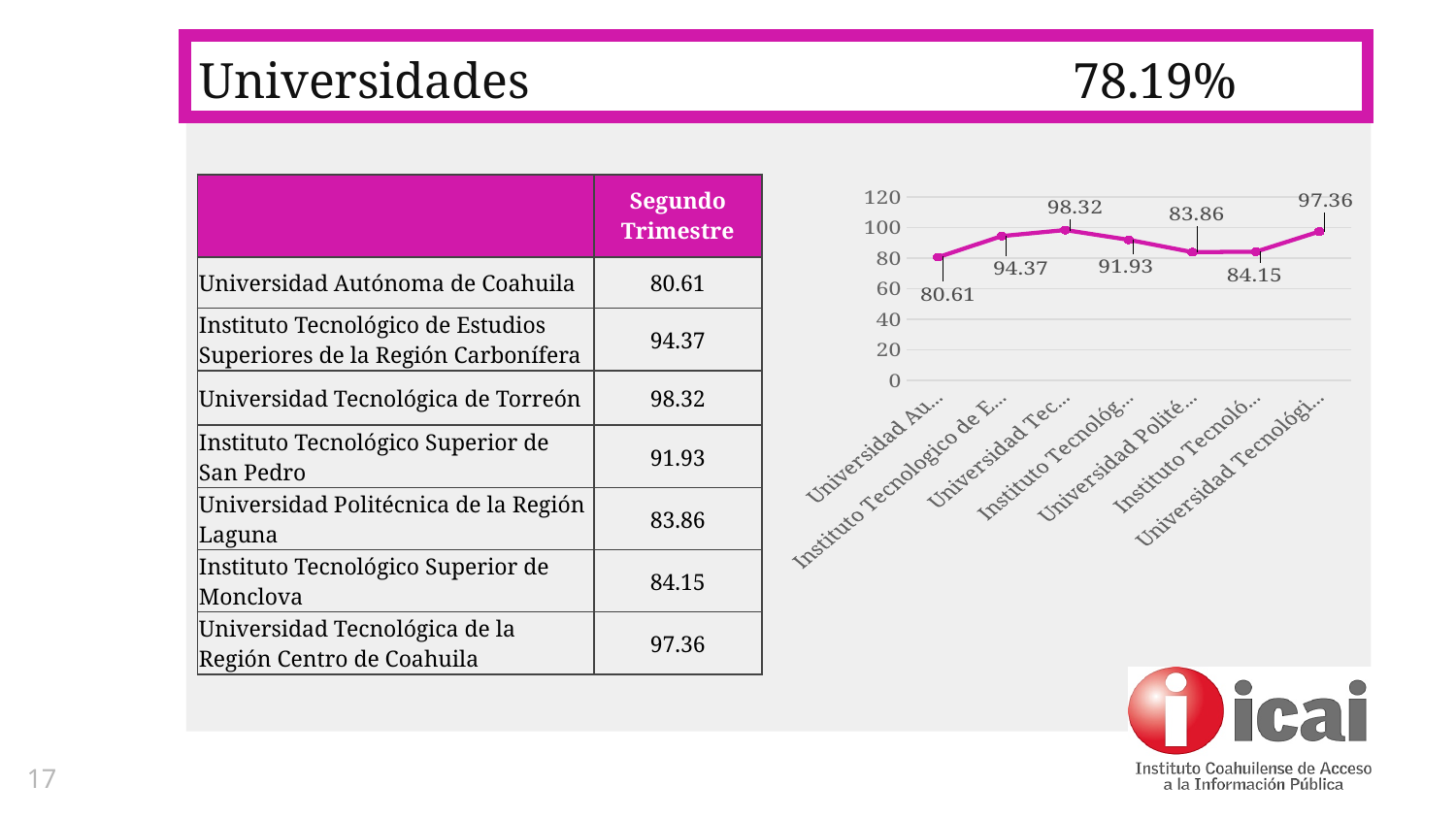
Which is larger on the line chart: the value for Instituto Tecnológico de Estudios Superiores de la Región Carbonífera or the value for Instituto Tecnológico Superior de San Pedro? Instituto Tecnológico de Estudios Superiores de la Región Carbonífera What is the value plotted for Universidad Tecnológica de Torreón, the third point on the line chart? 98.32 What is the value plotted for Universidad Autónoma de Coahuila, the first point on the line chart? 80.61 What is the difference between the values for Universidad Tecnológica de la Región Centro de Coahuila (97.36) and Instituto Tecnológico Superior de Monclova (84.15) on the line chart? 13.21 What is the value plotted for Instituto Tecnológico Superior de Monclova, the sixth point on the line chart? 84.15 What is the maximum value shown on the vertical axis of the line chart? 120 What type of chart is shown on the slide? line chart What is the difference between the highest value (98.32) and the lowest value (80.61) on the line chart? 17.71 Is the value for Universidad Politécnica de la Región Laguna on the line chart greater or less than 100? less Which university has the lowest value on the line chart? Universidad Autónoma de Coahuila Which university has the highest value on the line chart? Universidad Tecnológica de Torreón How many data points are plotted on the line chart? 7